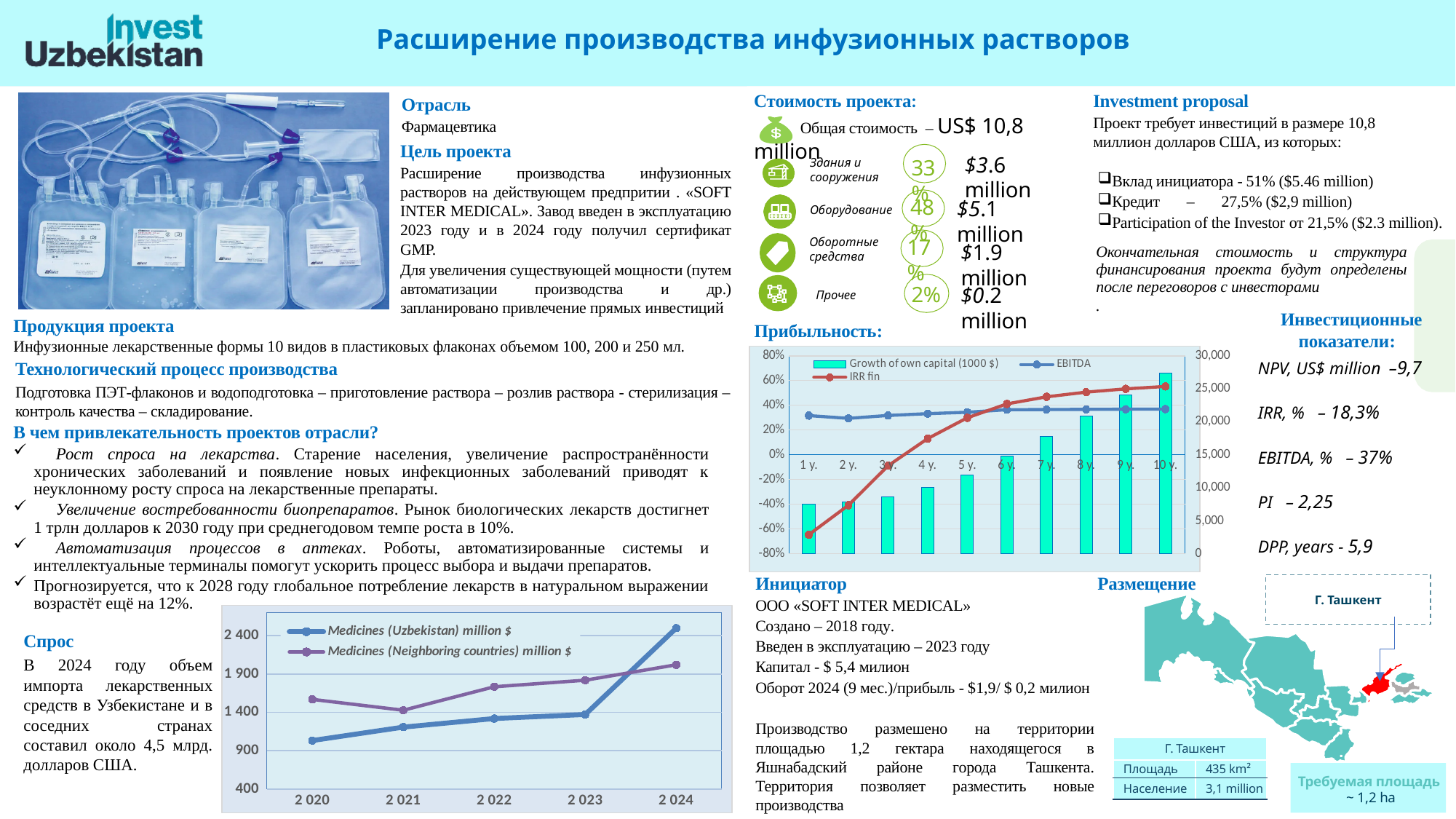
How many years are plotted on the x axis of the 'Спрос' chart? 5 In the 'Спрос' chart, which series is larger in 2020: Medicines (Uzbekistan) or Medicines (Neighboring countries)? Medicines (Neighboring countries) In the 'Спрос' chart, which year has the lowest value for Medicines (Uzbekistan) million $? 2020 In the 'Спрос' chart, is the value for Medicines (Uzbekistan) in 2020 greater or less than 1 400? less In the 'Прибыльность' chart, how many years are shown on the x axis? 10 In the 'Спрос' chart, which series is larger in 2024: Medicines (Uzbekistan) or Medicines (Neighboring countries)? Medicines (Uzbekistan) In the 'Прибыльность' chart, how many series does the legend list? 3 In the 'Прибыльность' chart, in which year is Growth of own capital (1000 $) highest? 10 y. In the 'Спрос' chart, which year has the highest value for Medicines (Uzbekistan) million $? 2024 How many series does the legend of the 'Спрос' chart list? 2 In the 'Прибыльность' chart, does the IRR fin line rise or fall from 1 y. to 10 y.? rise What kind of chart is the 'Спрос' chart at the bottom of the slide? line chart